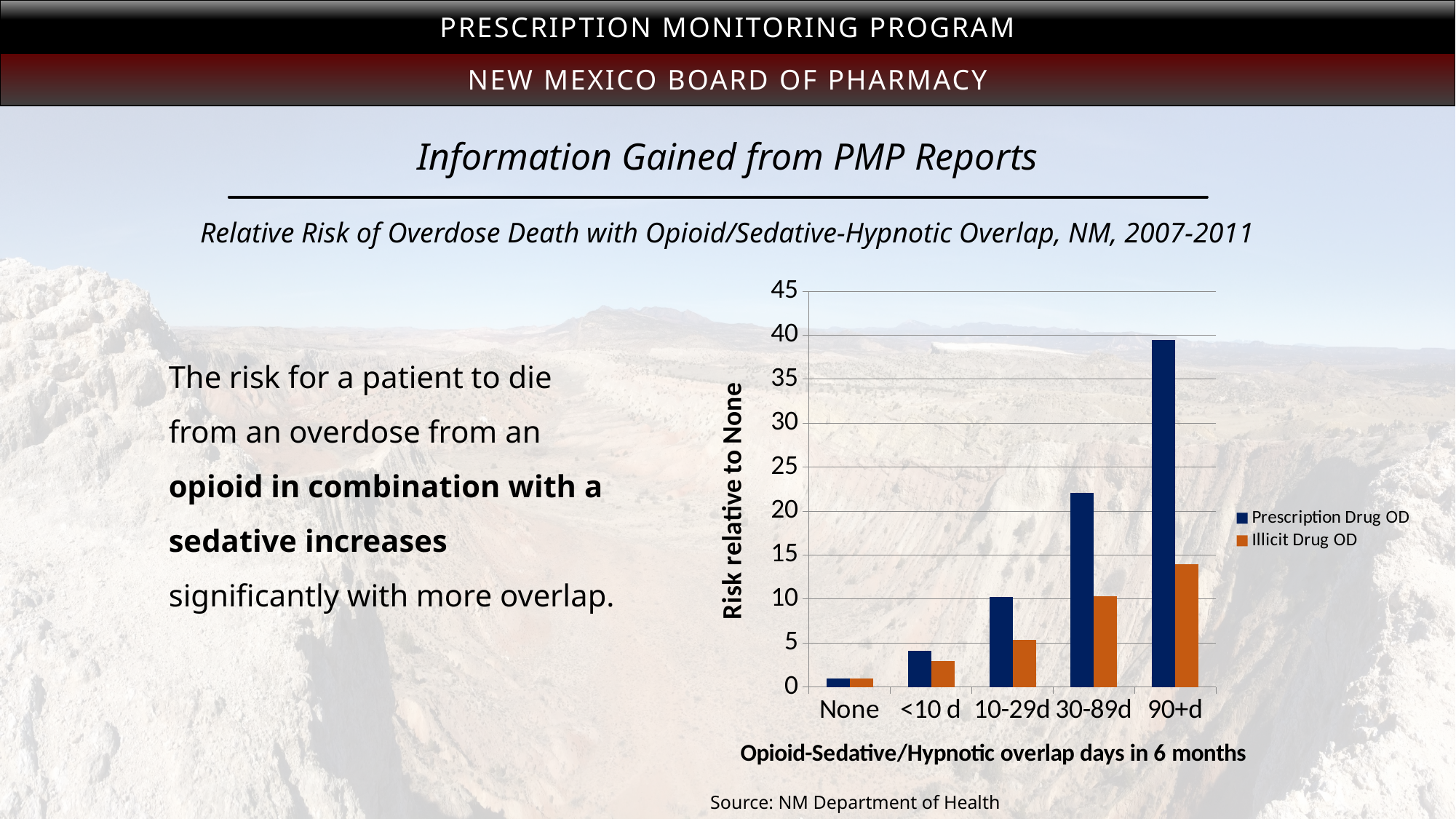
What kind of chart is shown on the slide? Bar chart Do the Prescription Drug OD values rise or fall as overlap days increase along the x axis? Rise How many series does the chart's legend list? 2 What is the title of the chart's y axis? Risk relative to None Is the Illicit Drug OD value for 10-29d greater or less than 10? less How many overlap-day categories are shown on the x axis? 5 Is the Prescription Drug OD value for 30-89d greater or less than 15? greater Is the Prescription Drug OD value for 90+d greater or less than 35? greater Which overlap category has the lowest Prescription Drug OD relative risk? None Which overlap category has the highest Prescription Drug OD relative risk? 90+d For the 30-89d category, which series has the larger value, Prescription Drug OD or Illicit Drug OD? Prescription Drug OD